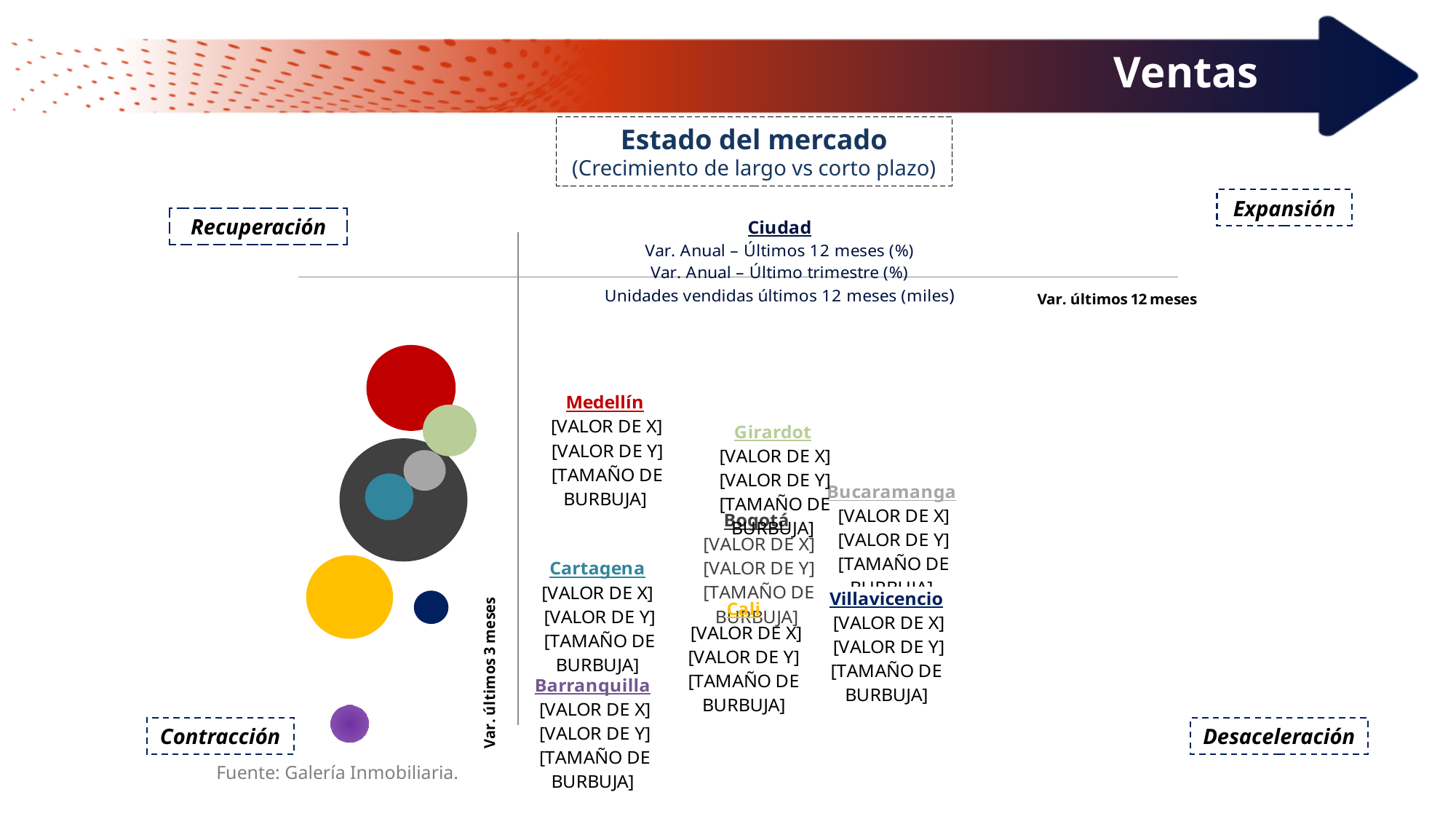
Which colour bubble is the largest on the chart? dark grey How many bubbles are plotted on the chart? 8 What kind of chart is shown on the slide? bubble chart What is the label of the vertical axis of the chart? Var. últimos 3 meses What is the title of the chart? Estado del mercado (Crecimiento de largo vs corto plazo) How many cities are labelled on the chart? 8 Which colour bubble is positioned highest on the vertical axis? red Which colour bubble is the smallest on the chart? dark blue Which is positioned higher on the vertical axis, the yellow bubble or the red bubble? red Which colour bubble is positioned lowest on the vertical axis? purple